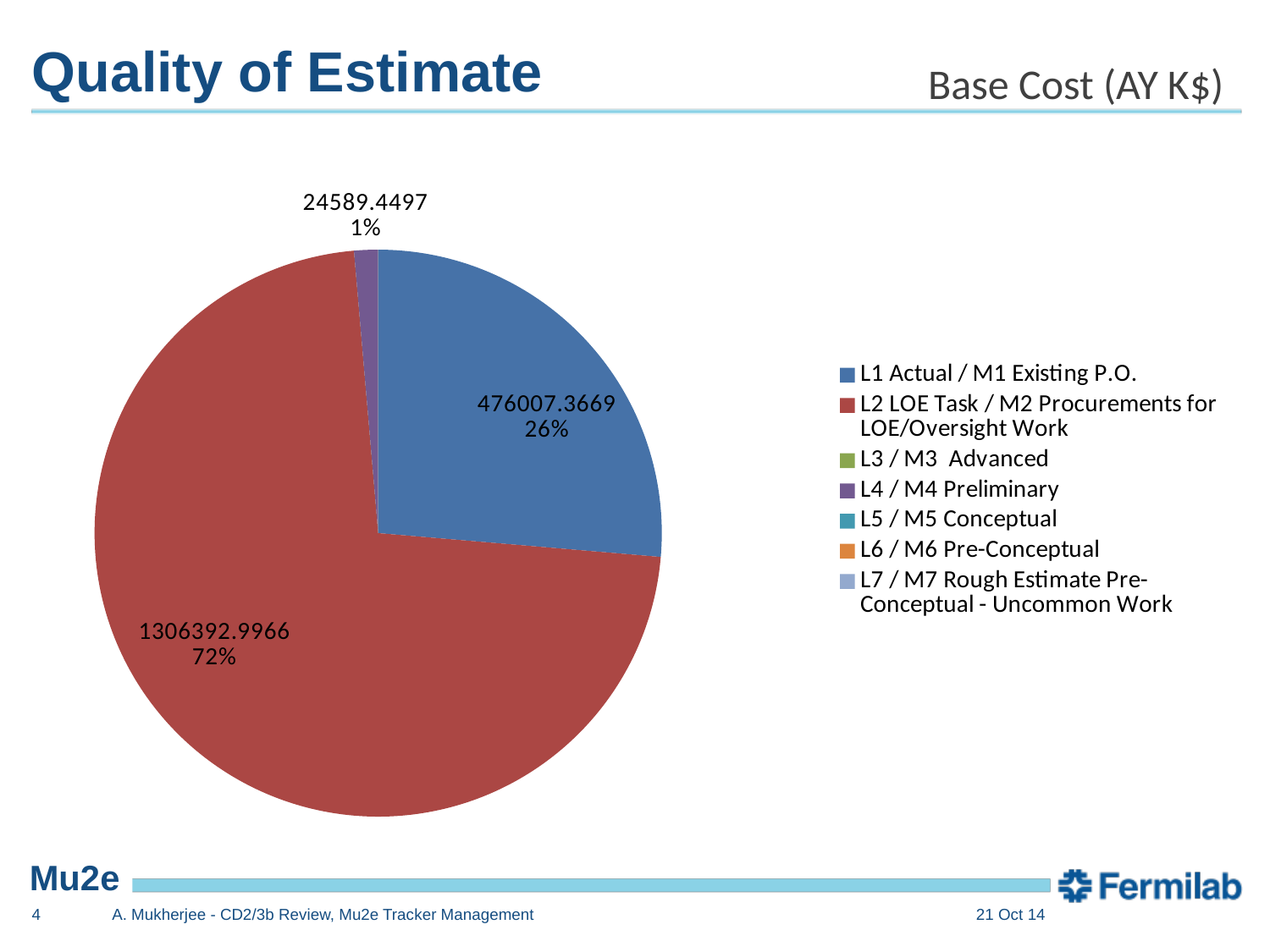
What percentage share of the pie does the L4 / M4 Preliminary slice represent? 1% What type of chart is shown on the slide? pie chart What percentage share of the pie does the L2 LOE Task / M2 Procurements for LOE/Oversight Work slice represent? 72% What percentage share of the pie does the L1 Actual / M1 Existing P.O. slice represent? 26% What is the value shown for the L2 LOE Task / M2 Procurements for LOE/Oversight Work slice? 1306392.9966 Which category has the largest slice of the pie? L2 LOE Task / M2 Procurements for LOE/Oversight Work Which is larger, the L1 Actual / M1 Existing P.O. slice or the L4 / M4 Preliminary slice? L1 Actual / M1 Existing P.O. Which of the labelled slices is the smallest? L4 / M4 Preliminary What is the value shown for the L4 / M4 Preliminary slice? 24589.4497 How many entries does the legend list? 7 What is the value shown for the L1 Actual / M1 Existing P.O. slice? 476007.3669 What is the difference between the L2 LOE Task / M2 Procurements for LOE/Oversight Work value and the L1 Actual / M1 Existing P.O. value? 830385.6297